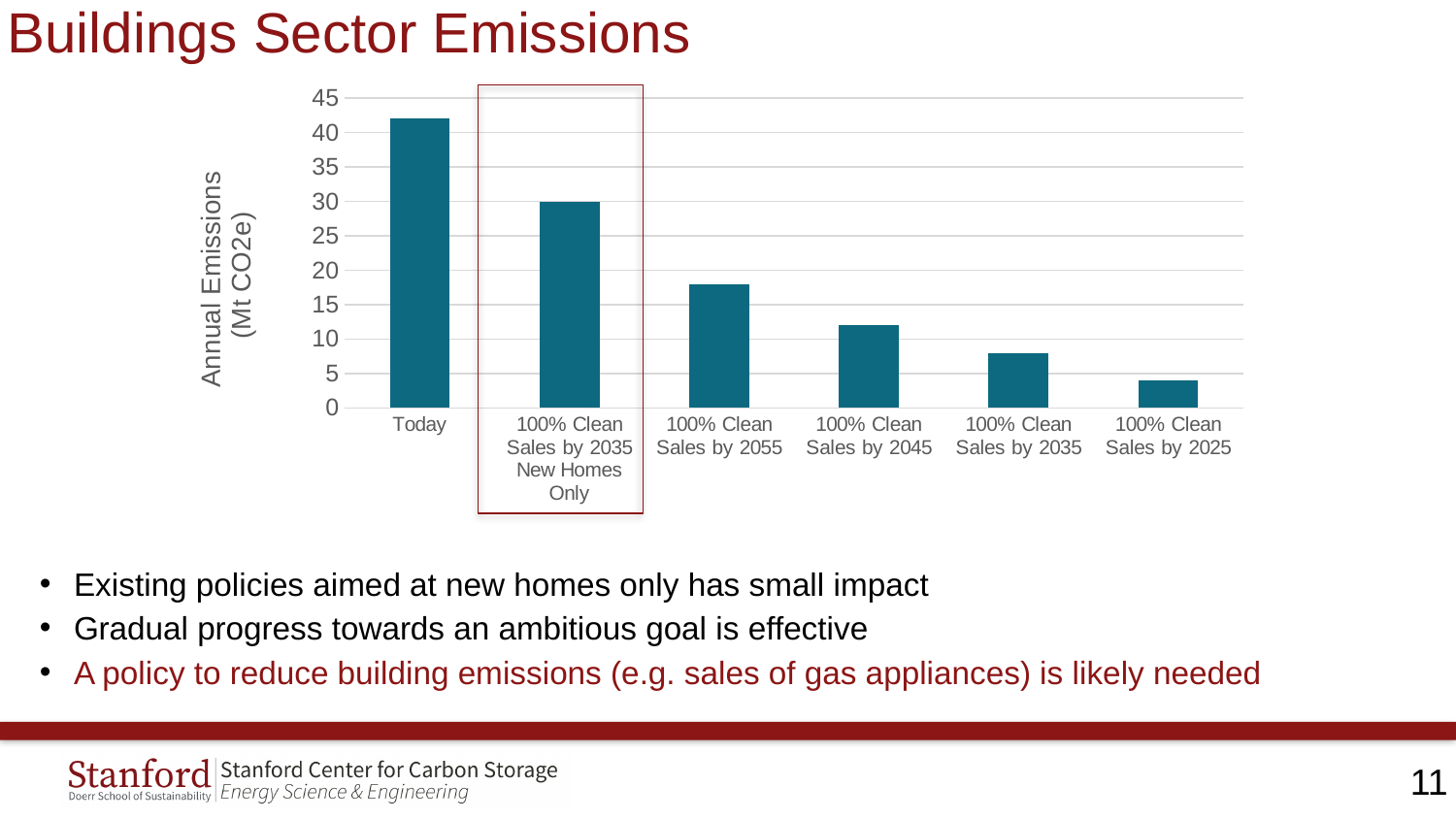
Which category has the highest annual emissions? Today Is the value for 100% Clean Sales by 2055 greater or less than 20? less What kind of chart is shown on the slide? bar chart Do the values rise or fall moving from left to right across the categories? fall How many bars (categories) are plotted in the chart? 6 Is the value for 100% Clean Sales by 2045 greater or less than 10? greater Is the value for 100% Clean Sales by 2025 greater or less than 5? less Which is larger: the value for 100% Clean Sales by 2035 New Homes Only or the value for 100% Clean Sales by 2035? 100% Clean Sales by 2035 New Homes Only What is the label of the vertical axis? Annual Emissions (Mt CO2e) Which category has the lowest annual emissions? 100% Clean Sales by 2025 Which category is highlighted with a red box on the chart? 100% Clean Sales by 2035 New Homes Only